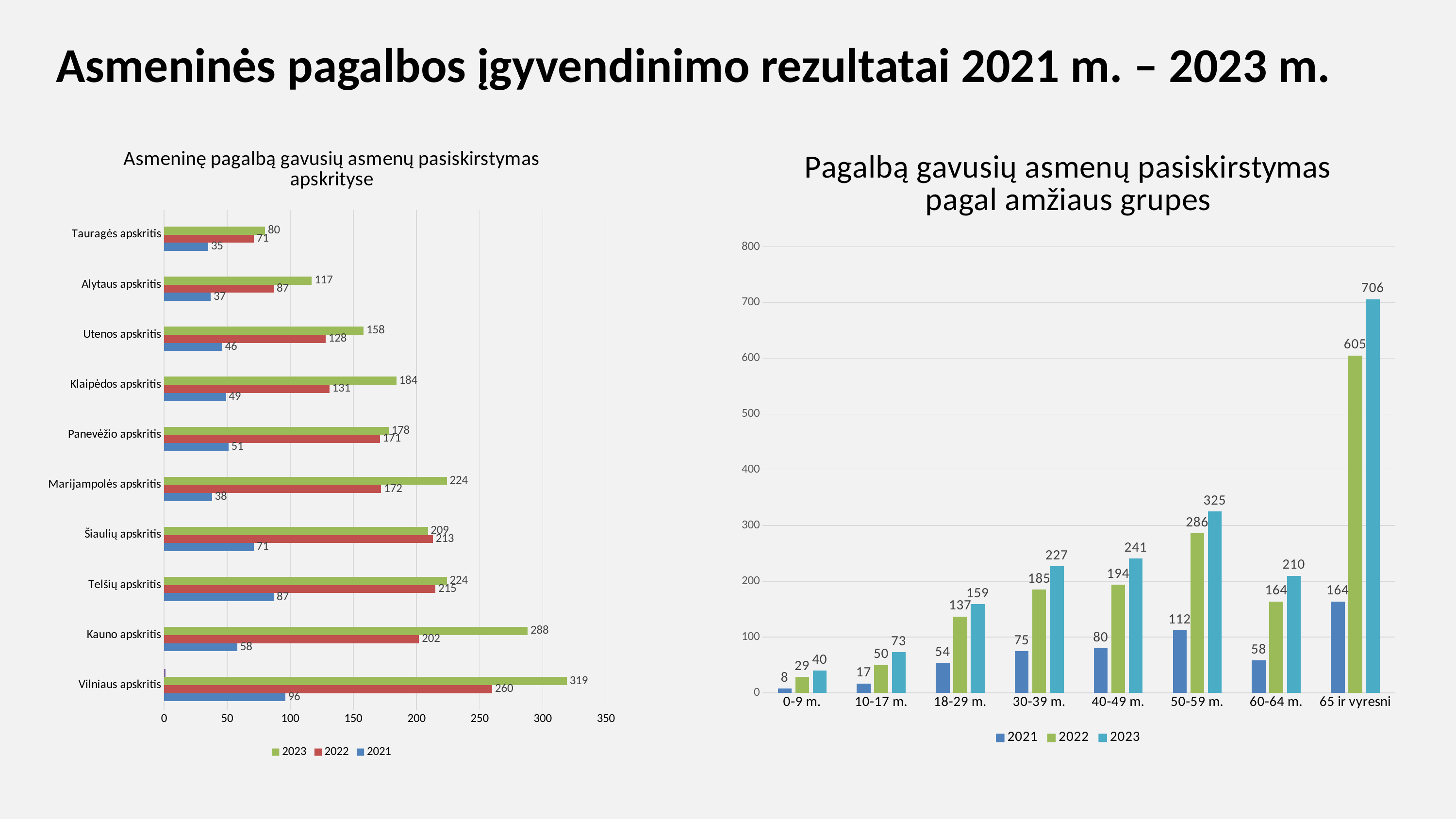
In the left chart (Asmeninę pagalbą gavusių asmenų pasiskirstymas apskrityse), which is larger for Šiaulių apskritis: the 2022 value or the 2023 value? 2022 In the right chart (Pagalbą gavusių asmenų pasiskirstymas pagal amžiaus grupes), what is the 2023 value for the 65 ir vyresni group? 706 In the left chart (Asmeninę pagalbą gavusių asmenų pasiskirstymas apskrityse), which county has the highest 2022 value? Vilniaus apskritis In the left chart (Asmeninę pagalbą gavusių asmenų pasiskirstymas apskrityse), which county has the lowest 2021 value? Tauragės apskritis What kind of chart is the right chart (Pagalbą gavusių asmenų pasiskirstymas pagal amžiaus grupes)? Bar chart In the right chart (Pagalbą gavusių asmenų pasiskirstymas pagal amžiaus grupes), what is the 2021 value for the 50-59 m. group? 112 In the left chart (Asmeninę pagalbą gavusių asmenų pasiskirstymas apskrityse), what is the 2023 value for Vilniaus apskritis? 319 In the left chart (Asmeninę pagalbą gavusių asmenų pasiskirstymas apskrityse), how many counties are shown? 10 In the right chart (Pagalbą gavusių asmenų pasiskirstymas pagal amžiaus grupes), which age group has the lowest 2022 value? 0-9 m. In the left chart (Asmeninę pagalbą gavusių asmenų pasiskirstymas apskrityse), what is the difference between the 2023 and 2022 values for Kauno apskritis? 86 In the left chart (Asmeninę pagalbą gavusių asmenų pasiskirstymas apskrityse), what is the 2021 value for Kauno apskritis? 58 In the right chart (Pagalbą gavusių asmenų pasiskirstymas pagal amžiaus grupes), how many series does the legend list? 3